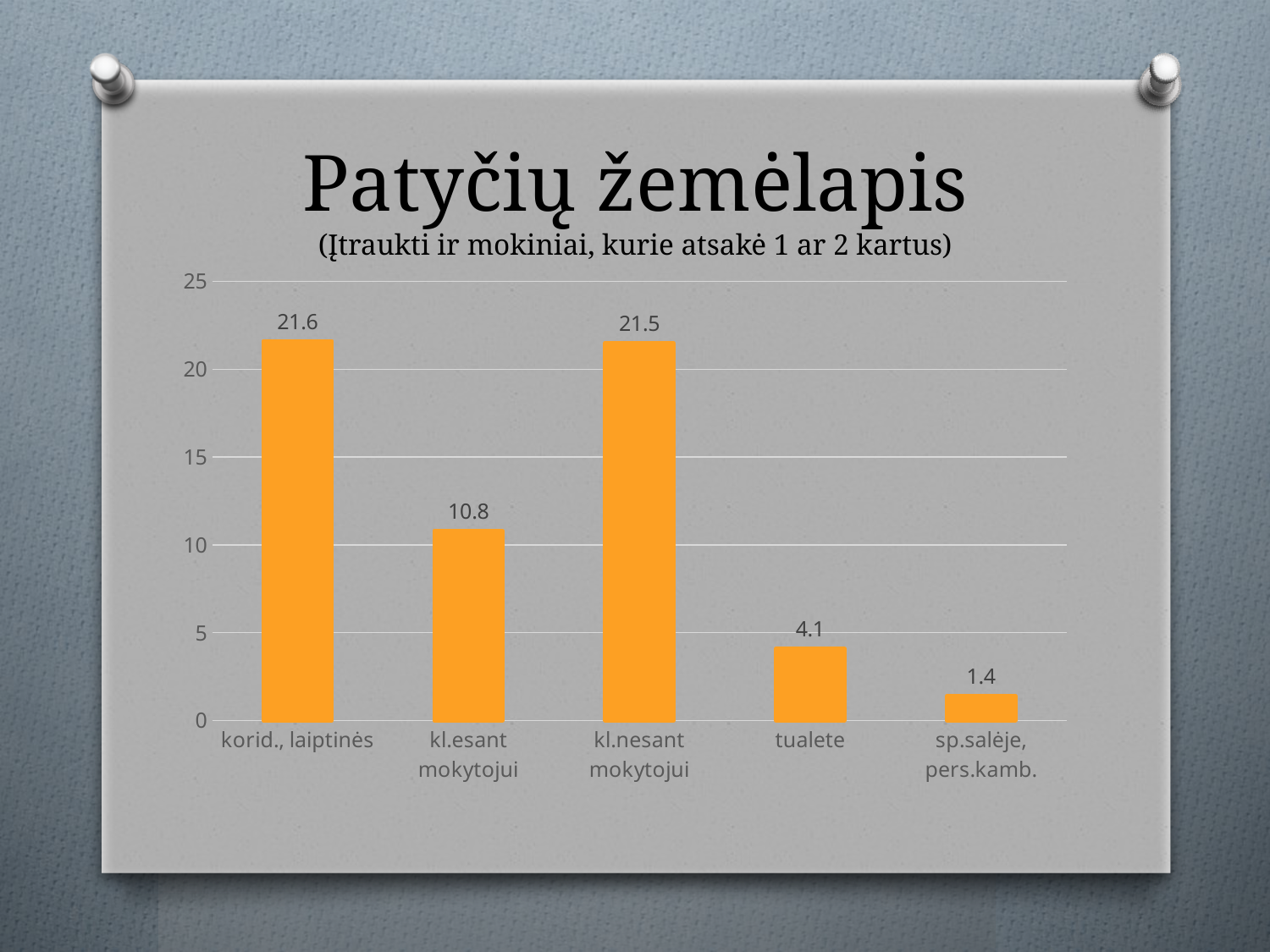
What is the difference between the values for kl.esant mokytojui and tualete? 6.7 What is the title of the chart on the slide? Patyčių žemėlapis How many categories are shown in the chart? 5 What is the value for korid., laiptinės? 21.6 What is the value for tualete? 4.1 What is the difference between the values for korid., laiptinės and kl.esant mokytojui? 10.8 What is the value for kl.esant mokytojui? 10.8 What is the value for kl.nesant mokytojui? 21.5 Which category has the lowest value? sp.salėje, pers.kamb. What is the value for sp.salėje, pers.kamb.? 1.4 What kind of chart is shown on the slide? bar chart Which is larger, the value for kl.esant mokytojui or the value for tualete? kl.esant mokytojui